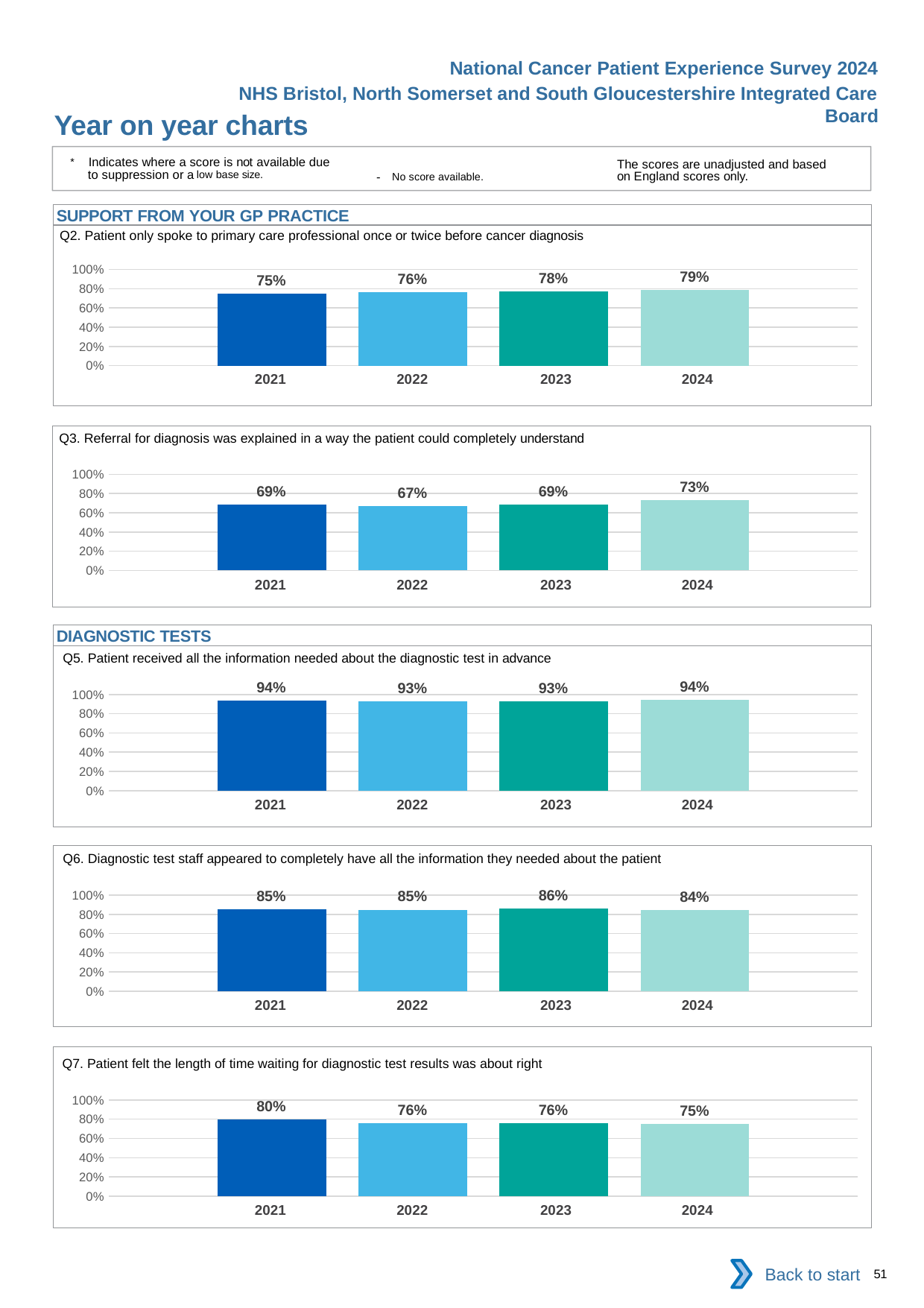
In the Q2 chart, do the values rise or fall from 2021 to 2024? rise In the Q6 chart (diagnostic test staff appeared to completely have all the information they needed about the patient), which year has the lowest value? 2024 What type of chart is used for Q2? bar chart In the Q3 chart (referral for diagnosis was explained in a way the patient could completely understand), which year has the highest value? 2024 In the Q6 chart, is the value for 2023 larger or smaller than the value for 2024? larger In the Q7 chart, what is the difference between the 2021 and 2024 values? 5 percentage points In the Q3 chart, which year has the lowest value? 2022 In the Q7 chart (patient felt the length of time waiting for diagnostic test results was about right), what is the value for 2021? 80% In the Q5 chart (patient received all the information needed about the diagnostic test in advance), what is the value for 2022? 93% In the Q3 chart, what is the difference between the 2024 and 2022 values? 6 percentage points How many years are shown on the x axis of the Q7 chart? 4 In the Q2 chart (patient only spoke to primary care professional once or twice before cancer diagnosis), what is the value for 2024? 79%